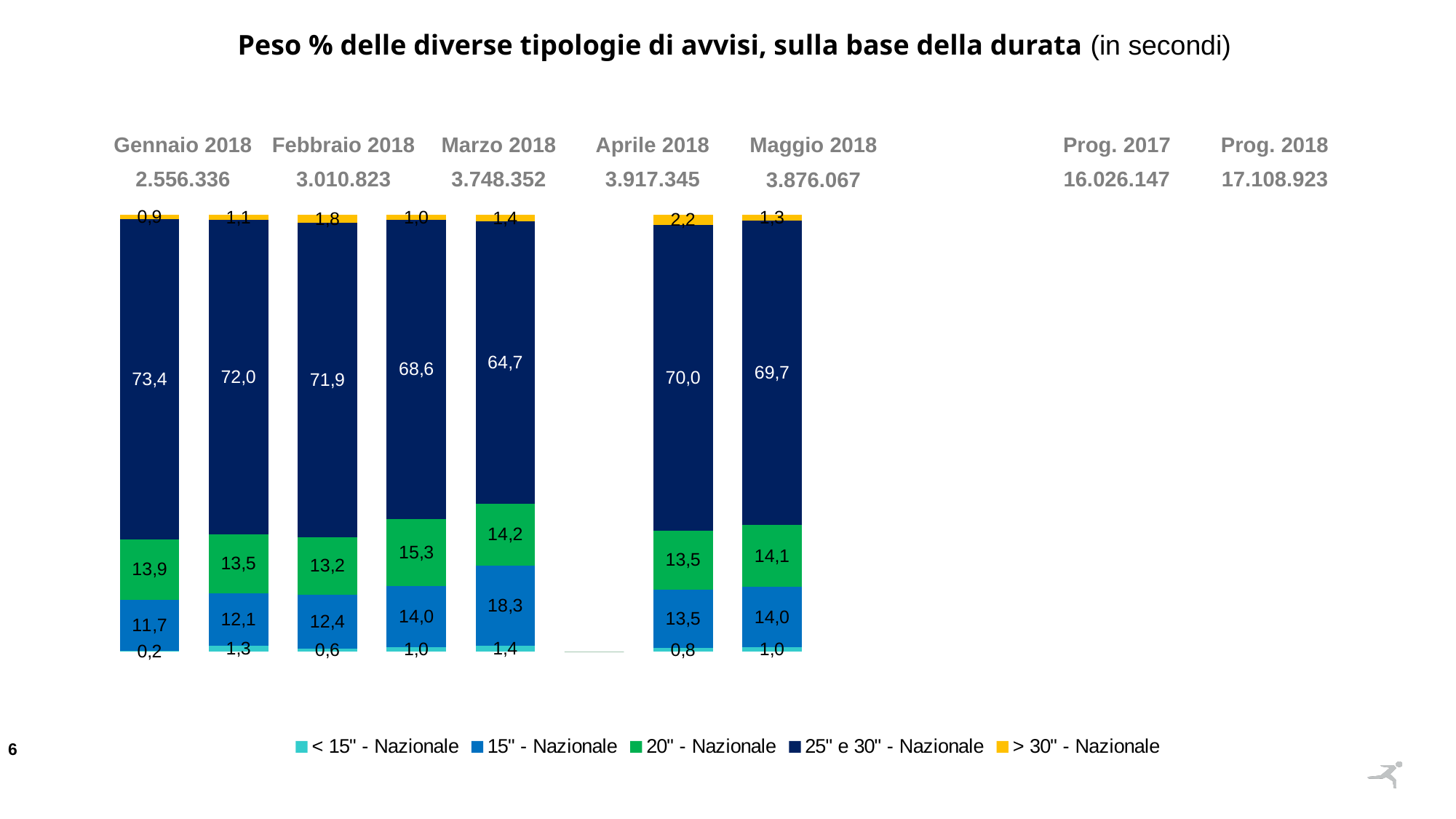
What is the value of the '15'' - Nazionale' segment in the fifth bar from the left? 18,3 How many stacked bars are plotted in the chart? 7 Which is larger: the '20'' - Nazionale' segment in the fourth bar from the left or in the fifth bar from the left? The fourth bar (15,3) What kind of chart is shown on the slide? Stacked bar chart Which bar has the highest '25'' e 30'' - Nazionale' value? The leftmost bar (73,4) How many series does the legend list? 5 Which bar has the largest '> 30'' - Nazionale' segment? The sixth bar from the left (2,2) What colour represents the '> 30'' - Nazionale' series in the legend? Yellow Which bar has the lowest '25'' e 30'' - Nazionale' value? The fifth bar from the left (64,7) What is the difference between the highest and lowest '25'' e 30'' - Nazionale' values (73,4 and 64,7)? 8,7 What is the value of the '25'' e 30'' - Nazionale' segment in the leftmost bar? 73,4 What is the value of the '> 30'' - Nazionale' segment in the sixth bar from the left? 2,2